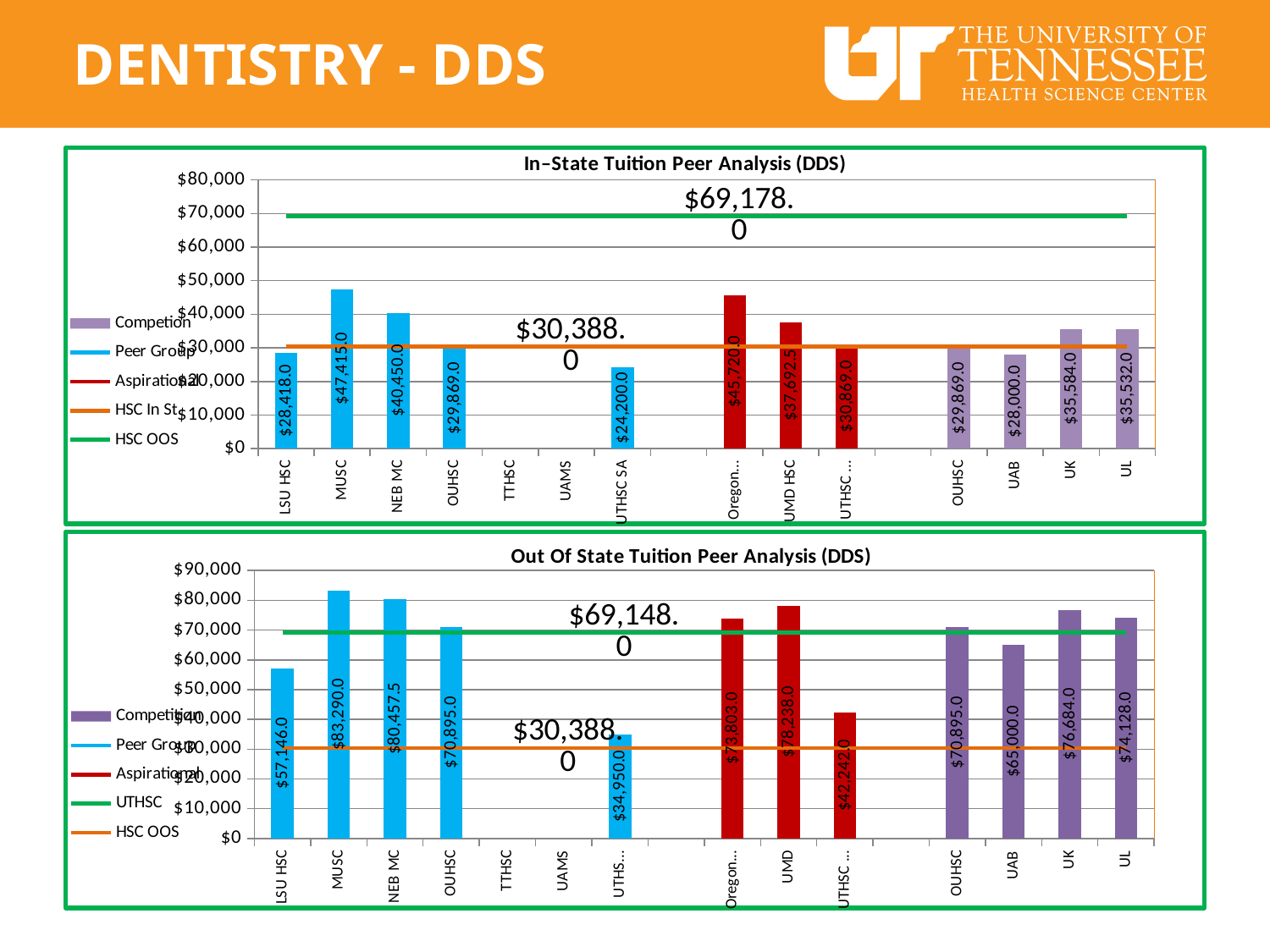
In the In-State Tuition Peer Analysis (DDS) chart, which school has the lowest bar? UTHSC SA What kind of chart is the In-State Tuition Peer Analysis (DDS) chart? bar chart In the In-State Tuition Peer Analysis (DDS) chart, which school has the highest bar? MUSC In the In-State Tuition Peer Analysis (DDS) chart, what is the difference between the MUSC and LSU HSC values? $18,997.0 In the Out Of State Tuition Peer Analysis (DDS) chart, what is the value for UK? $76,684.0 How many entries does the legend of the In-State Tuition Peer Analysis (DDS) chart list? 5 In the In-State Tuition Peer Analysis (DDS) chart, which is larger, the value for UK or the value for UL? UK In the Out Of State Tuition Peer Analysis (DDS) chart, what is the difference between the MUSC and NEB MC values? $2,832.5 In the In-State Tuition Peer Analysis (DDS) chart, what value is labelled on the green HSC OOS line? $69,178.0 In the Out Of State Tuition Peer Analysis (DDS) chart, what is the value for UAB? $65,000.0 In the Out Of State Tuition Peer Analysis (DDS) chart, is the value for LSU HSC greater or less than $60,000? less In the In-State Tuition Peer Analysis (DDS) chart, what is the value for MUSC? $47,415.0